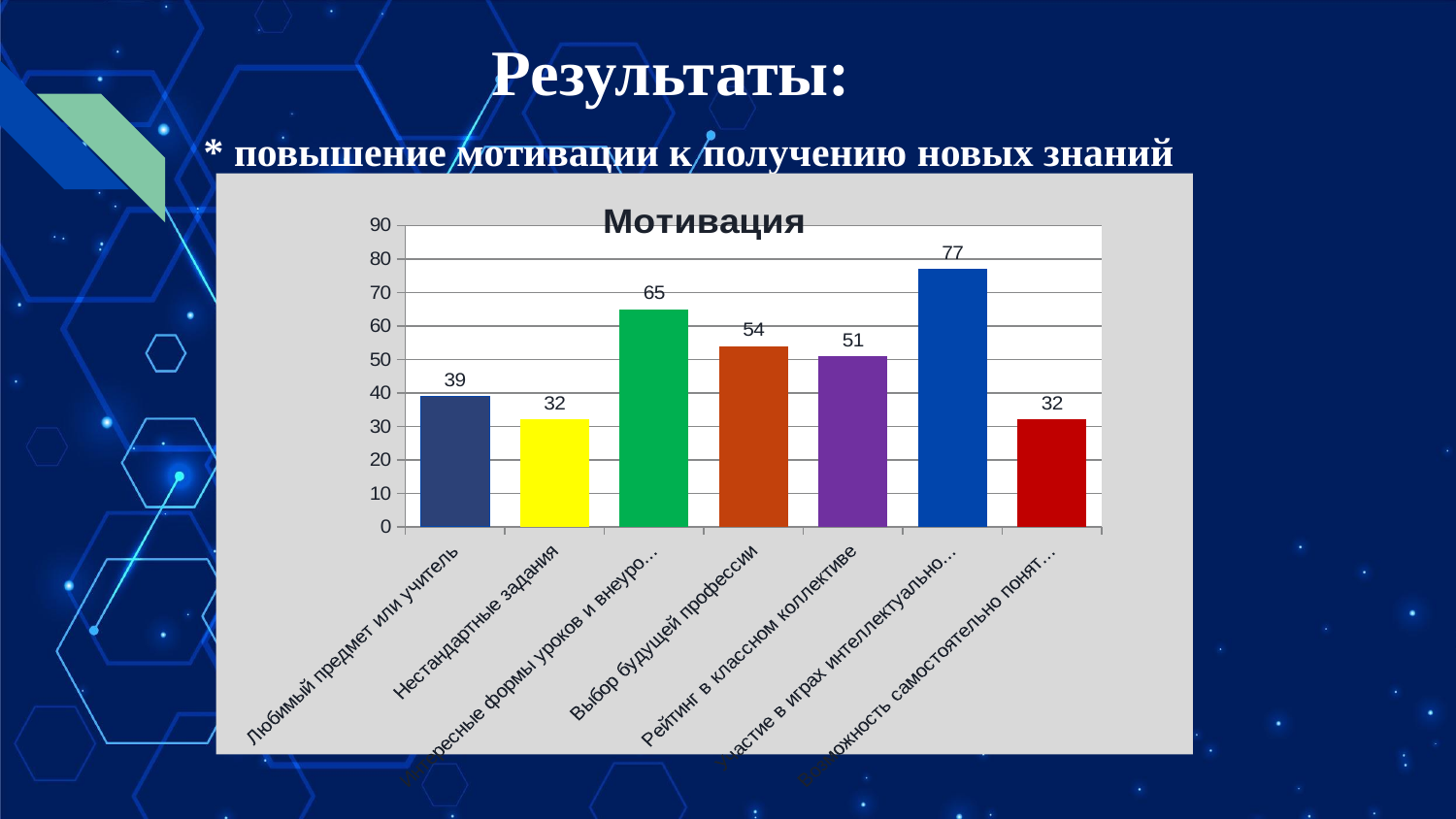
What is the difference between the values for 'Выбор будущей профессии' and 'Рейтинг в классном коллективе'? 3 What is the title of the chart? Мотивация Is the value for 'Выбор будущей профессии' greater or less than 50? greater What is the lowest value shown in the chart? 32 What is the value for 'Рейтинг в классном коллективе'? 51 Which is larger, the value for 'Любимый предмет или учитель' or the value for 'Нестандартные задания'? Любимый предмет или учитель What is the value for 'Любимый предмет или учитель'? 39 What is the value for 'Нестандартные задания'? 32 What type of chart is shown on the slide? Bar chart What is the value for 'Выбор будущей профессии'? 54 How many bars are plotted in the chart? 7 What is the highest value shown in the chart? 77